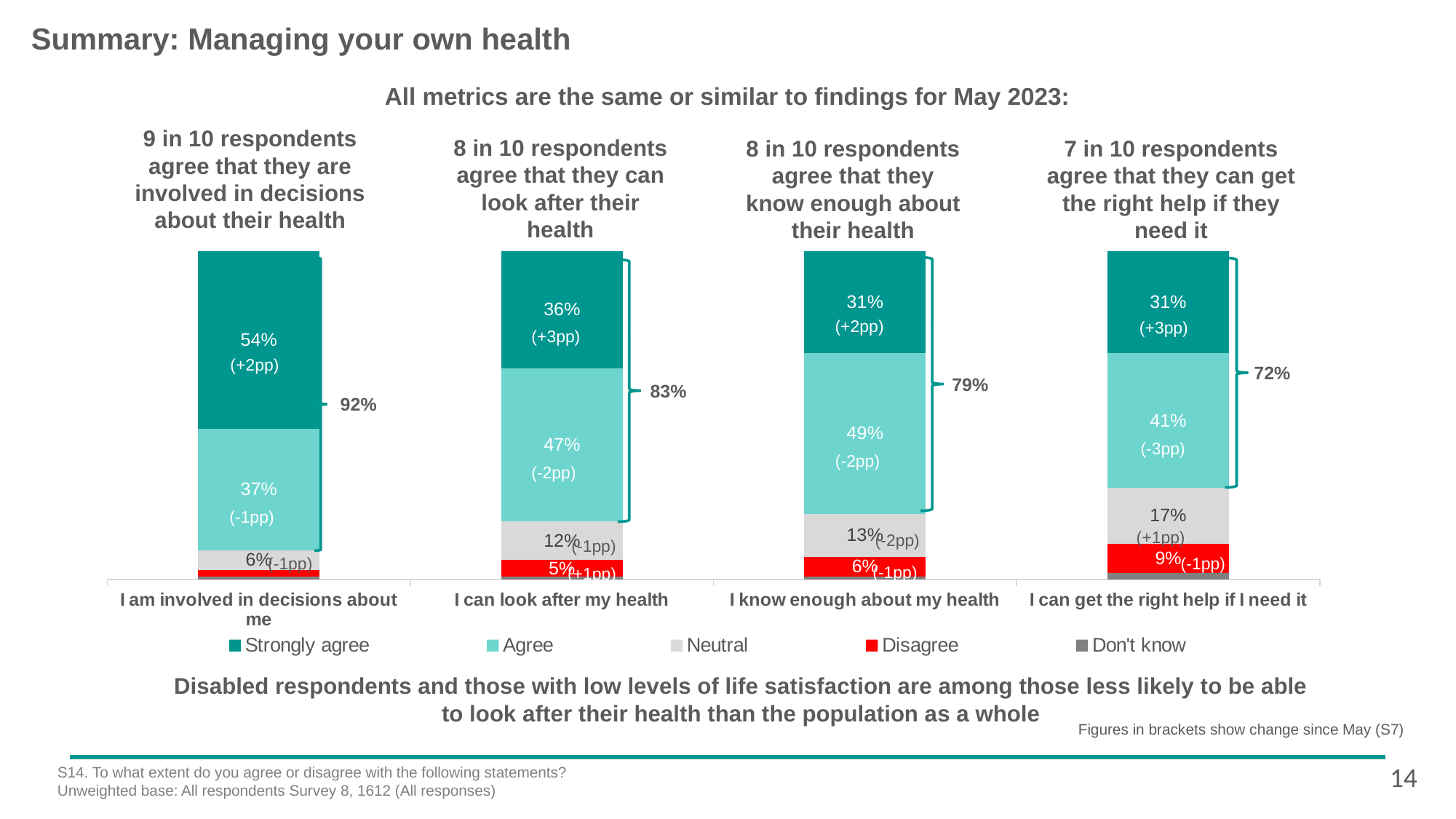
What is the combined agreement (strongly agree plus agree) shown for "I can look after my health"? 83% What is the Neutral percentage for "I can get the right help if I need it"? 17% How many statements (categories) are shown on the x axis of the chart? 4 How many series does the chart legend list? 5 What kind of chart is shown on the slide? Stacked bar chart Which statement has the highest combined agreement percentage? I am involved in decisions about me Which statement has the lowest combined agreement percentage? I can get the right help if I need it What percentage of respondents agree (not strongly) with "I can look after my health"? 47% What is the Disagree percentage for "I know enough about my health"? 6% What is the difference between the combined agreement for "I am involved in decisions about me" (92%) and "I can get the right help if I need it" (72%)? 20 percentage points What percentage of respondents strongly agree with "I am involved in decisions about me"? 54% Which is larger: the Strongly agree share for "I am involved in decisions about me" or for "I can look after my health"? I am involved in decisions about me